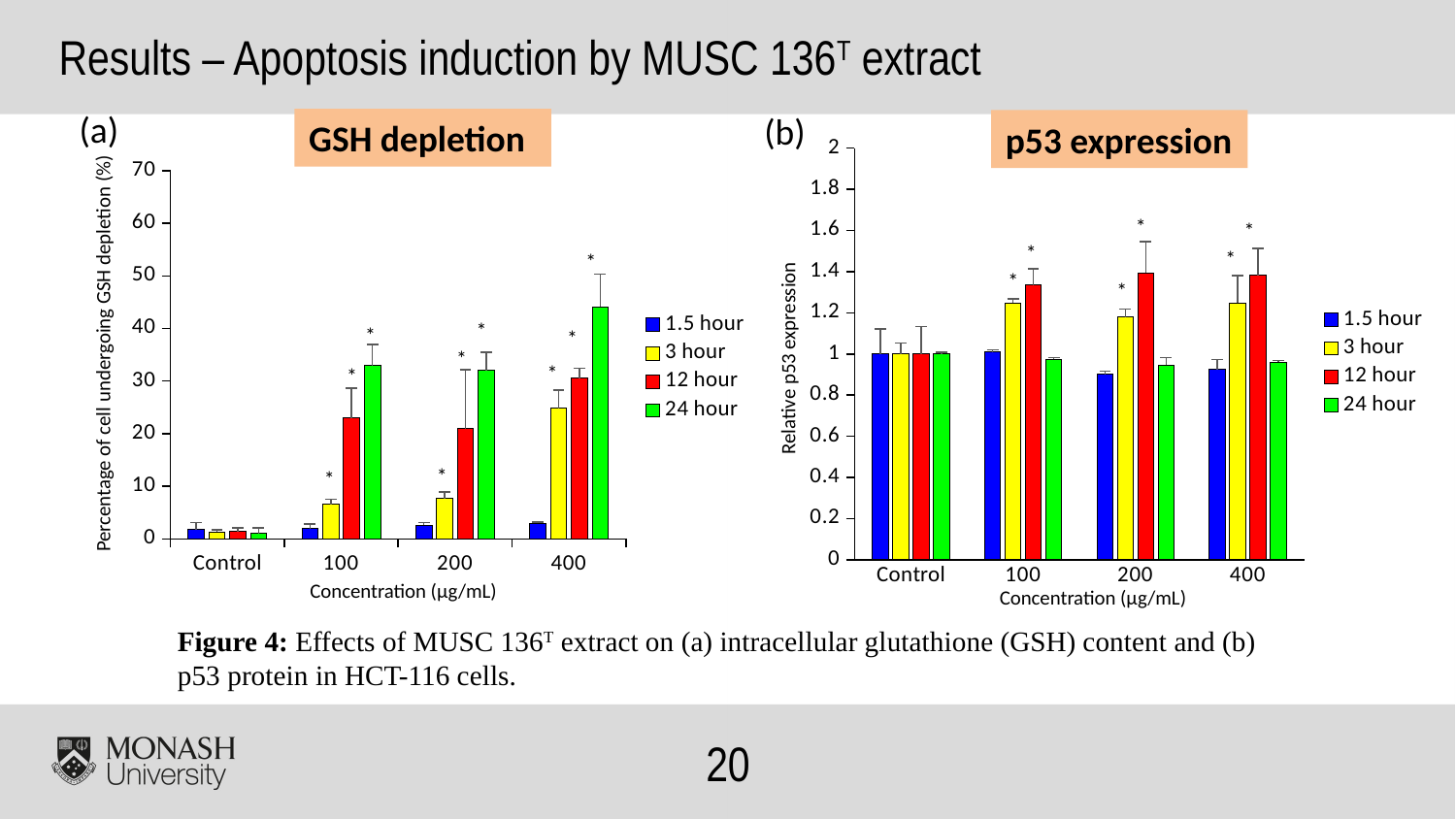
In the p53 expression chart (b), is the 1.5 hour value at 200 µg/mL greater or less than 1? less In the GSH depletion chart (a), at which concentration is the 24 hour bar highest? 400 In the p53 expression chart (b), which series has the highest bar at 400 µg/mL? 12 hour In the GSH depletion chart (a), is the 24 hour value at 400 µg/mL greater or less than 40? greater What is the x-axis label of the p53 expression chart (b)? Concentration (µg/mL) How many series does the legend of the p53 expression chart (b) list? 4 In the p53 expression chart (b), is the 12 hour value at 200 µg/mL greater or less than 1.2? greater In the GSH depletion chart (a), at 100 µg/mL, which is larger: the 12 hour bar or the 24 hour bar? 24 hour What kind of chart is the GSH depletion chart (a)? bar chart In the GSH depletion chart (a), do the 3 hour bars rise or fall from Control to 400 µg/mL? rise How many concentration categories are shown on the x axis of the GSH depletion chart (a)? 4